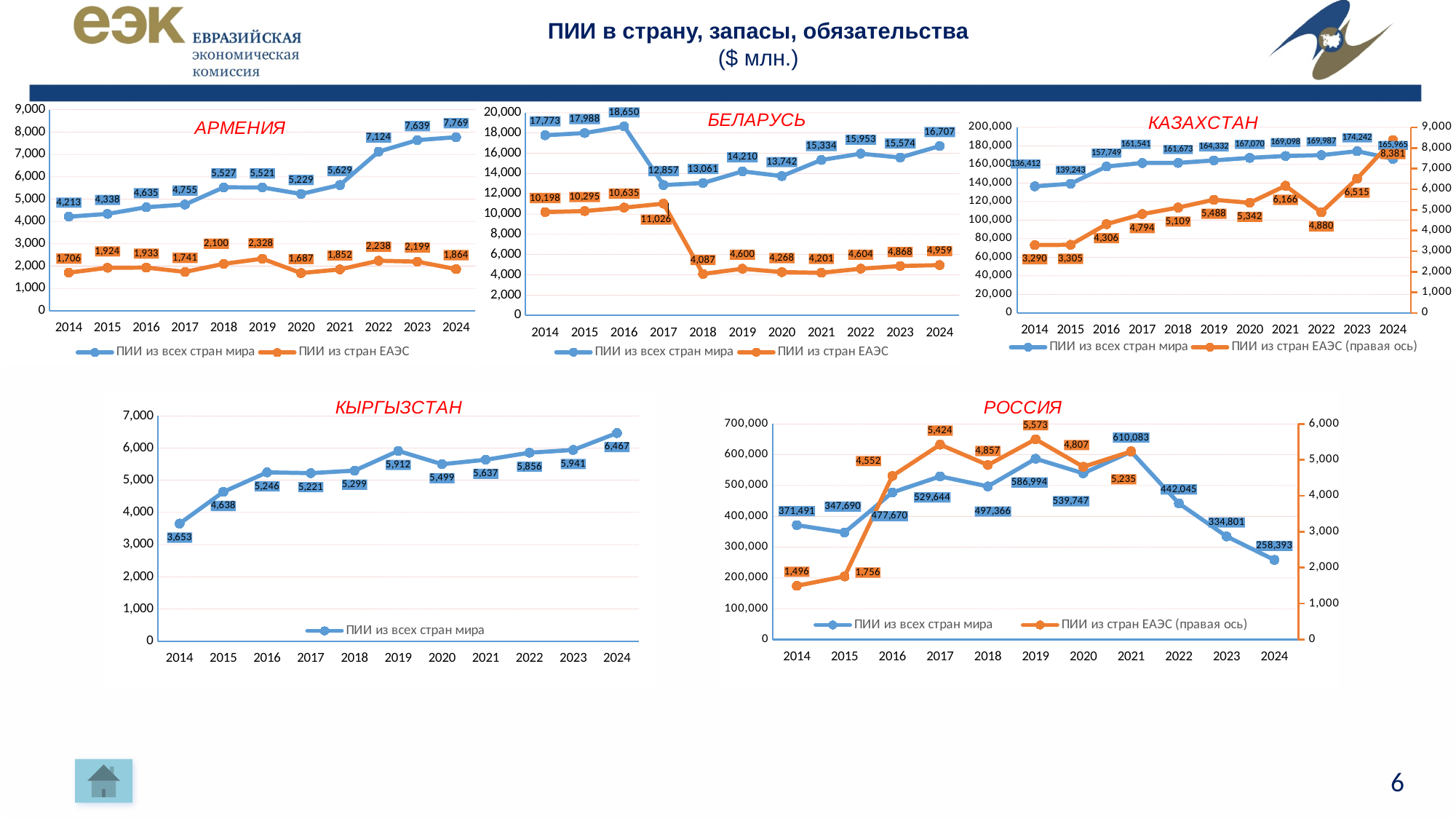
On the БЕЛАРУСЬ chart, what is the difference between ПИИ из всех стран мира in 2016 and in 2017? 5,793 On the КАЗАХСТАН chart, what is the value of ПИИ из стран ЕАЭС (правая ось) in 2024? 8,381 On the РОССИЯ chart, does ПИИ из всех стран мира rise or fall from 2021 to 2024? fall On the КЫРГЫЗСТАН chart, how many series does the legend list? 1 On the РОССИЯ chart, which is larger: ПИИ из всех стран мира in 2019 or in 2021? 2021 On the РОССИЯ chart, in which year is ПИИ из всех стран мира lowest? 2024 What type of chart is the КЫРГЫЗСТАН chart? line chart On the АРМЕНИЯ chart, in which year is ПИИ из стран ЕАЭС highest? 2019 On the КЫРГЫЗСТАН chart, what is the value for 2014? 3,653 On the АРМЕНИЯ chart, what is the value of ПИИ из всех стран мира in 2024? 7,769 On the БЕЛАРУСЬ chart, what is the value of ПИИ из стран ЕАЭС in 2018? 4,087 On the КАЗАХСТАН chart, in which year is ПИИ из всех стран мира highest? 2023